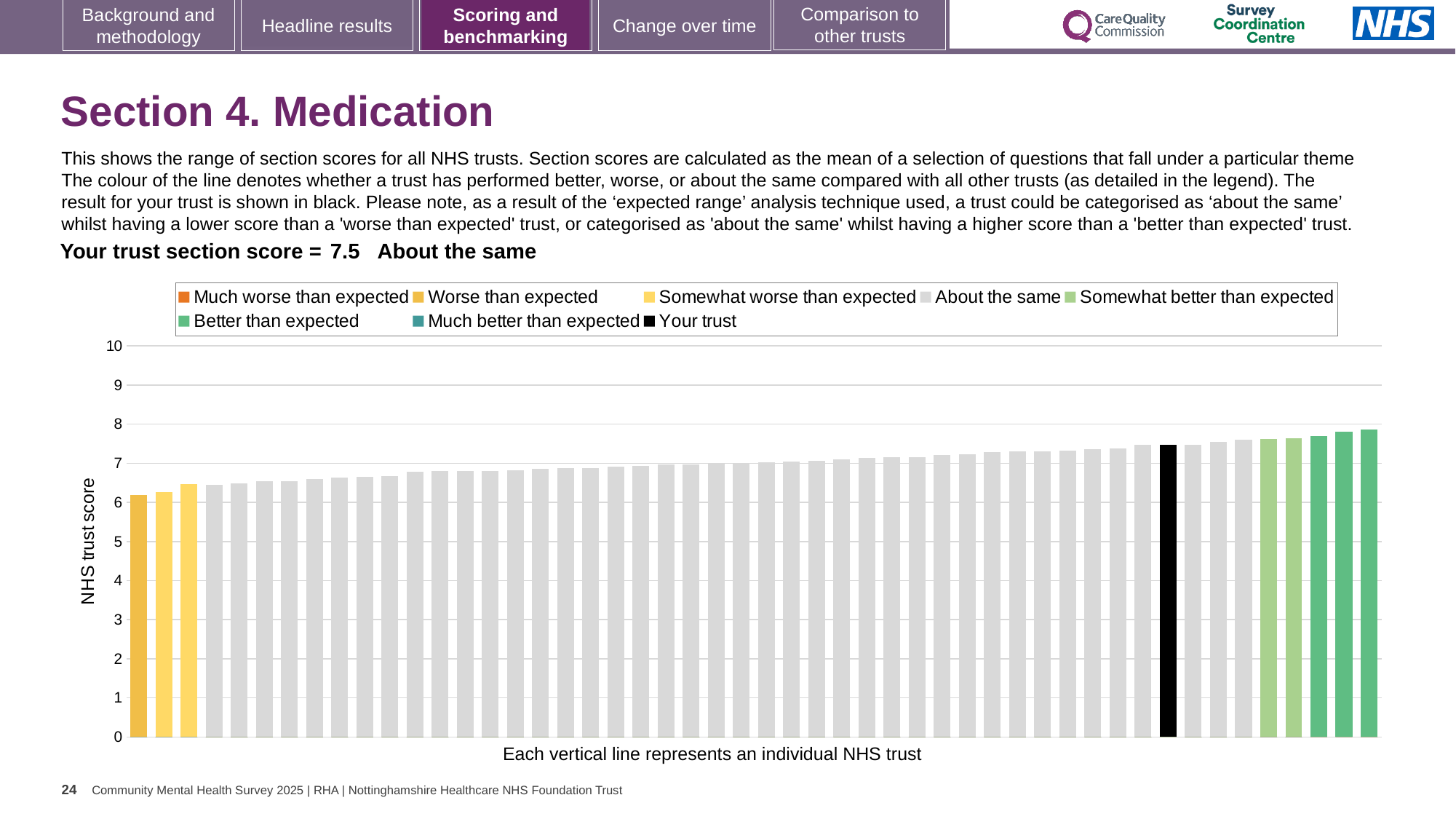
Is the value of the black bar (your trust) greater or less than 7? greater What is the title of the vertical axis? NHS trust score Is the value of the leftmost (lowest) bar greater or less than 6? greater What is the highest value shown on the vertical axis? 10 How many entries does the chart legend list? 8 Do the bar values rise or fall from left to right along the x axis? rise Is the value of the rightmost (highest) bar greater or less than 8? less What is the section score for your trust shown on the slide? 7.5 What colour is the bar representing your trust? black What kind of chart is shown on the slide? bar chart How is your trust's section score categorised compared with other trusts? About the same